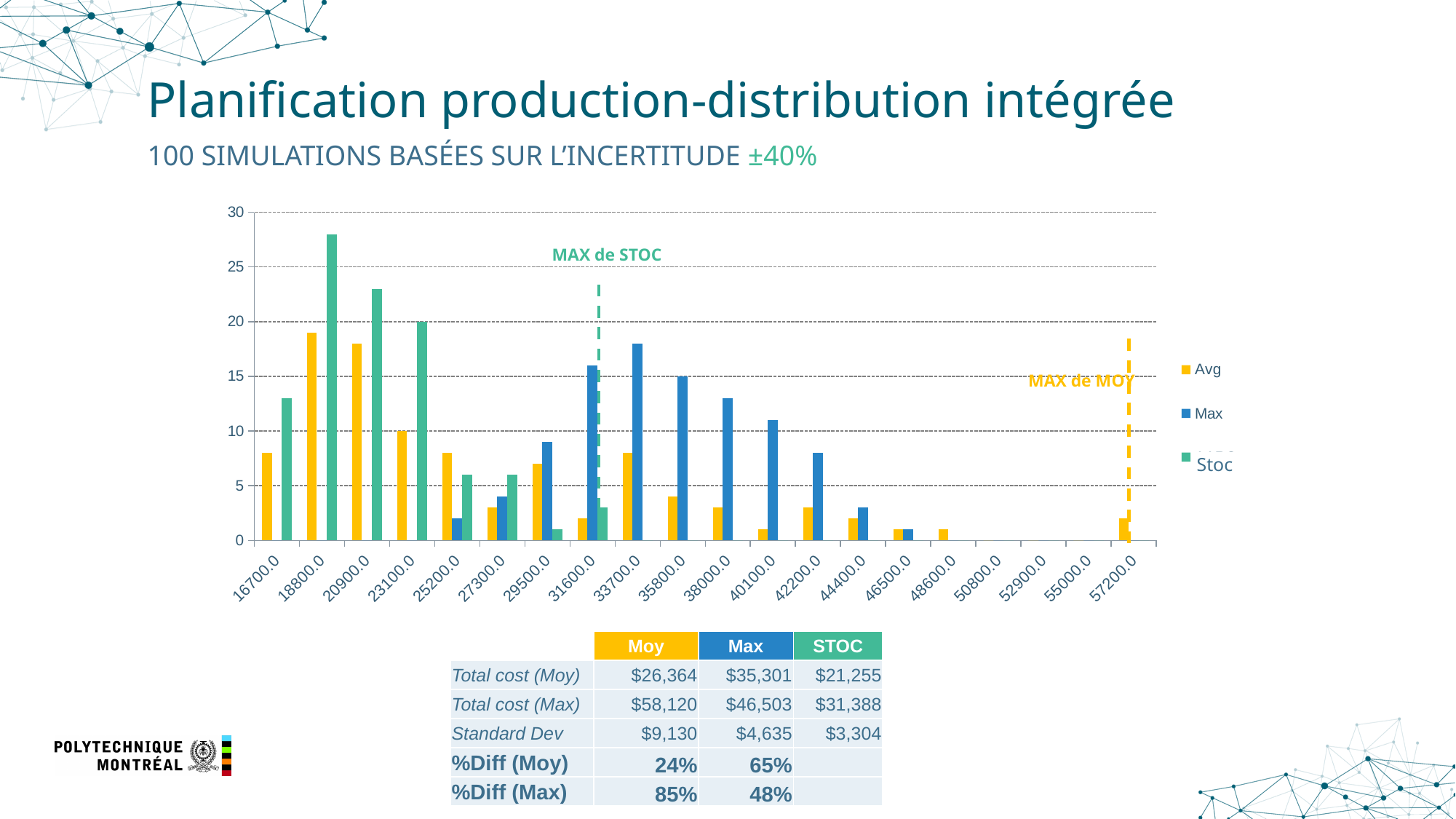
Is the value of the Stoc bar at 18800.0 greater or less than 25? greater Is the value of the Avg bar at 16700.0 greater or less than 10? less At which x-axis category does the Stoc series reach its highest bar? 18800.0 What kind of chart is shown on the slide? bar chart How many series does the chart legend list? 3 Which is larger at 38000.0: the Avg bar or the Max bar? Max How many categories are shown along the x axis of the chart? 20 Which is larger at 20900.0: the Avg bar or the Stoc bar? Stoc At which x-axis category does the Max series reach its highest bar? 33700.0 What label is written next to the green dashed vertical line in the chart? MAX de STOC Is the value of the Max bar at 31600.0 greater or less than 15? greater Which series is drawn in blue in the chart? Max